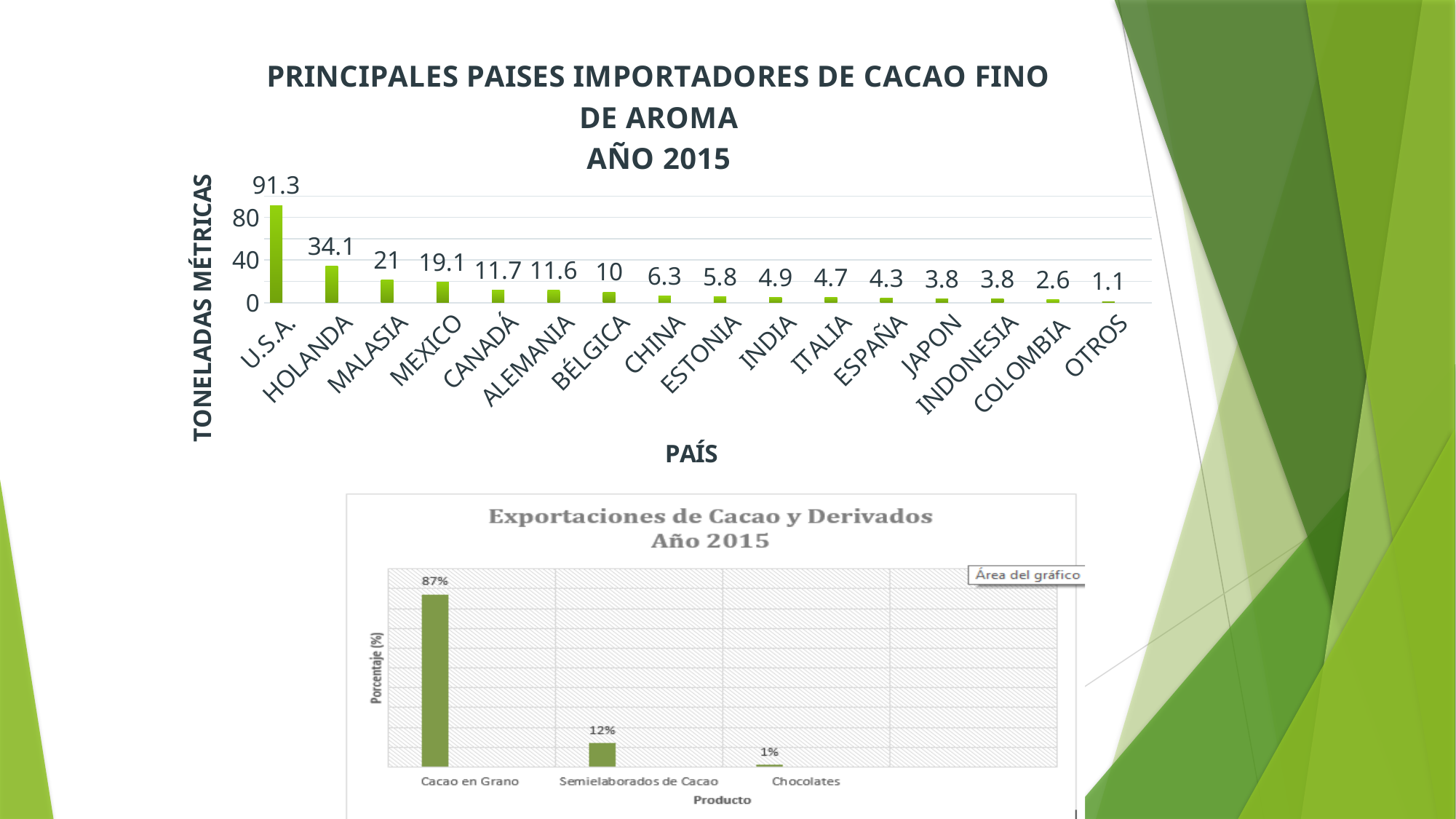
In the chart 'PRINCIPALES PAISES IMPORTADORES DE CACAO FINO DE AROMA AÑO 2015', how many countries/categories are shown on the x axis? 16 In the chart 'PRINCIPALES PAISES IMPORTADORES DE CACAO FINO DE AROMA AÑO 2015', what is the value for HOLANDA? 34.1 In the chart 'PRINCIPALES PAISES IMPORTADORES DE CACAO FINO DE AROMA AÑO 2015', which is larger, the value for MALASIA or the value for MEXICO? MALASIA What kind of chart is 'Exportaciones de Cacao y Derivados Año 2015'? bar chart In the chart 'Exportaciones de Cacao y Derivados Año 2015', what is the value for Semielaborados de Cacao? 12% What is the label of the y axis in the chart 'PRINCIPALES PAISES IMPORTADORES DE CACAO FINO DE AROMA AÑO 2015'? TONELADAS MÉTRICAS In the chart 'PRINCIPALES PAISES IMPORTADORES DE CACAO FINO DE AROMA AÑO 2015', what is the value for CANADÁ? 11.7 In the chart 'PRINCIPALES PAISES IMPORTADORES DE CACAO FINO DE AROMA AÑO 2015', what is the difference between the values for U.S.A. and HOLANDA? 57.2 In the chart 'PRINCIPALES PAISES IMPORTADORES DE CACAO FINO DE AROMA AÑO 2015', which category has the lowest value? OTROS In the chart 'PRINCIPALES PAISES IMPORTADORES DE CACAO FINO DE AROMA AÑO 2015', do the values rise or fall from left to right along the x axis? fall In the chart 'PRINCIPALES PAISES IMPORTADORES DE CACAO FINO DE AROMA AÑO 2015', which country has the highest value? U.S.A. In the chart 'Exportaciones de Cacao y Derivados Año 2015', which product has the highest value? Cacao en Grano